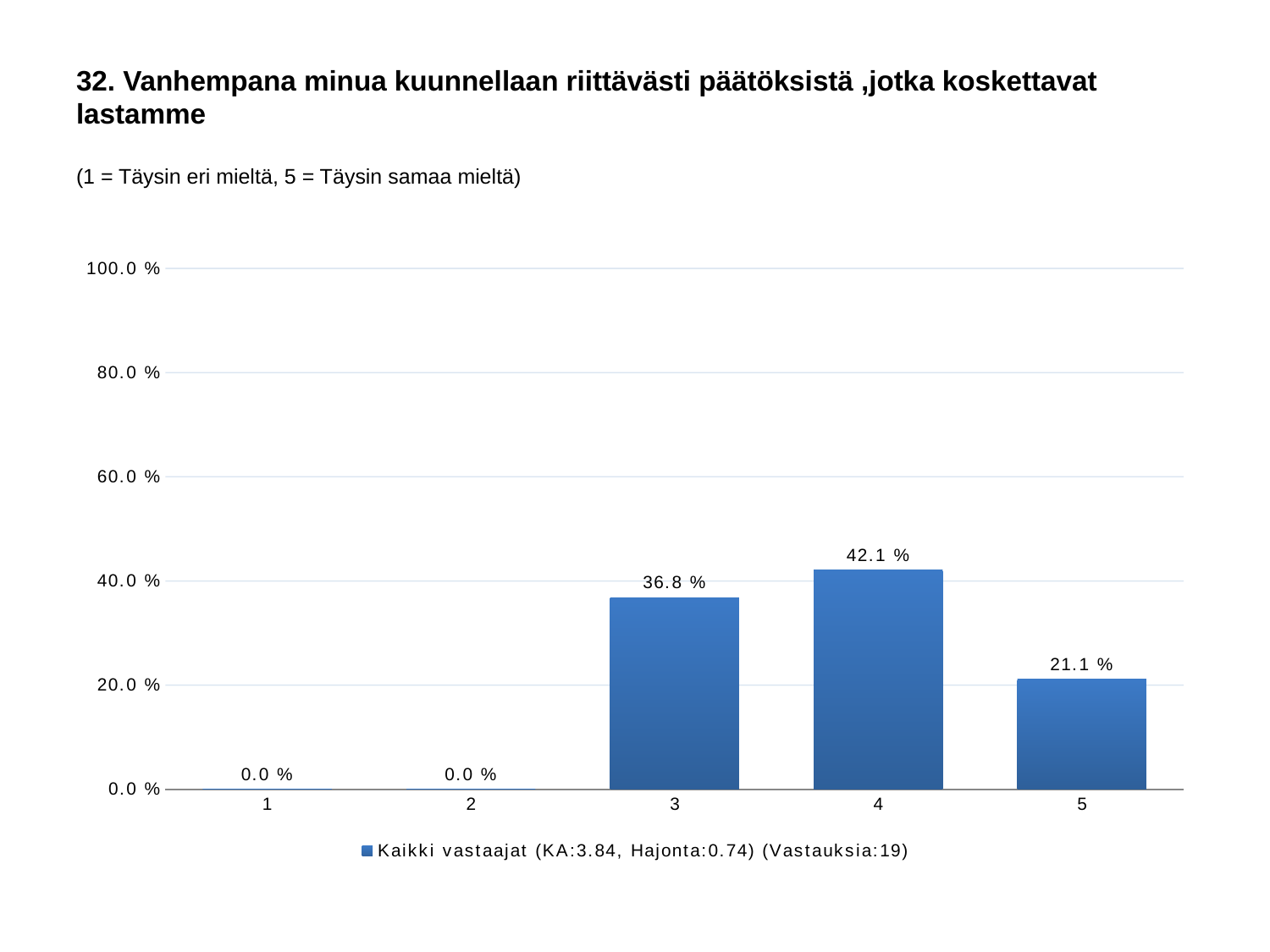
What is the value for category 1? 0.0 % Is the value for category 5 greater or less than 40.0 %? less What is the value for category 5? 21.1 % What is the value for category 3? 36.8 % How many categories are shown on the x axis? 5 Which is larger, the value for category 4 or the value for category 5? 4 What is the value for category 4? 42.1 % What kind of chart is shown on the slide? bar chart What is the difference between the values for categories 3 and 5? 15.7 % What is the difference between the values for categories 4 and 3? 5.3 % How many responses (Vastauksia) does the legend report? 19 Which category has the highest value? 4